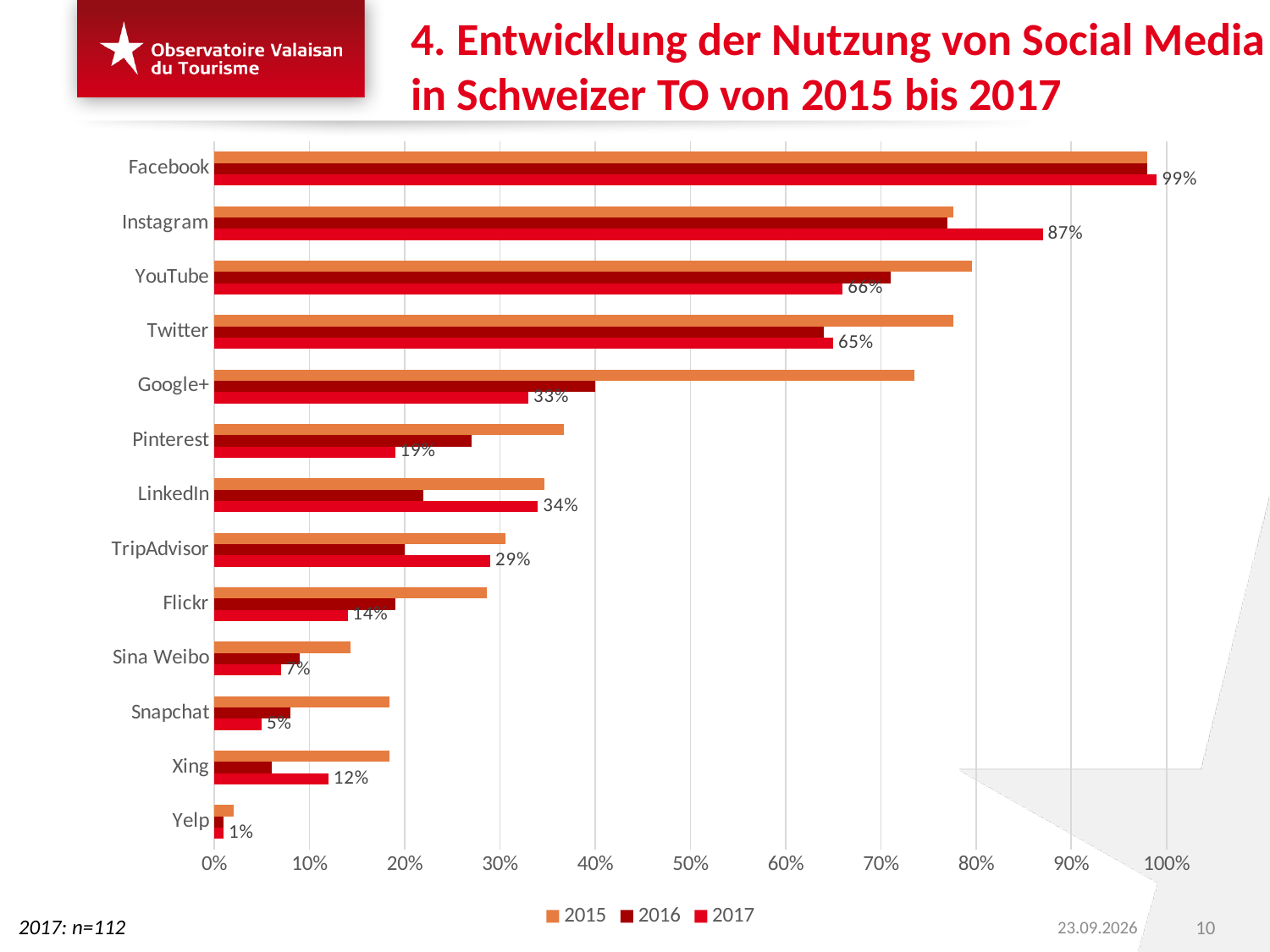
What is the 2017 value for Xing? 12% How many platforms are shown on the chart? 13 How many series does the legend list? 3 Which platform has the lowest 2017 value? Yelp Is the 2015 value for Google+ greater or less than 70%? greater What is the 2017 value for TripAdvisor? 29% What kind of chart is shown on the slide? Bar chart What is the difference between the 2017 values for Facebook and Instagram? 12% Which has the larger 2017 value, LinkedIn or Google+? LinkedIn What is the 2017 value for Instagram? 87% Is the 2015 value for Yelp greater or less than 10%? less Which platform has the highest 2017 value? Facebook